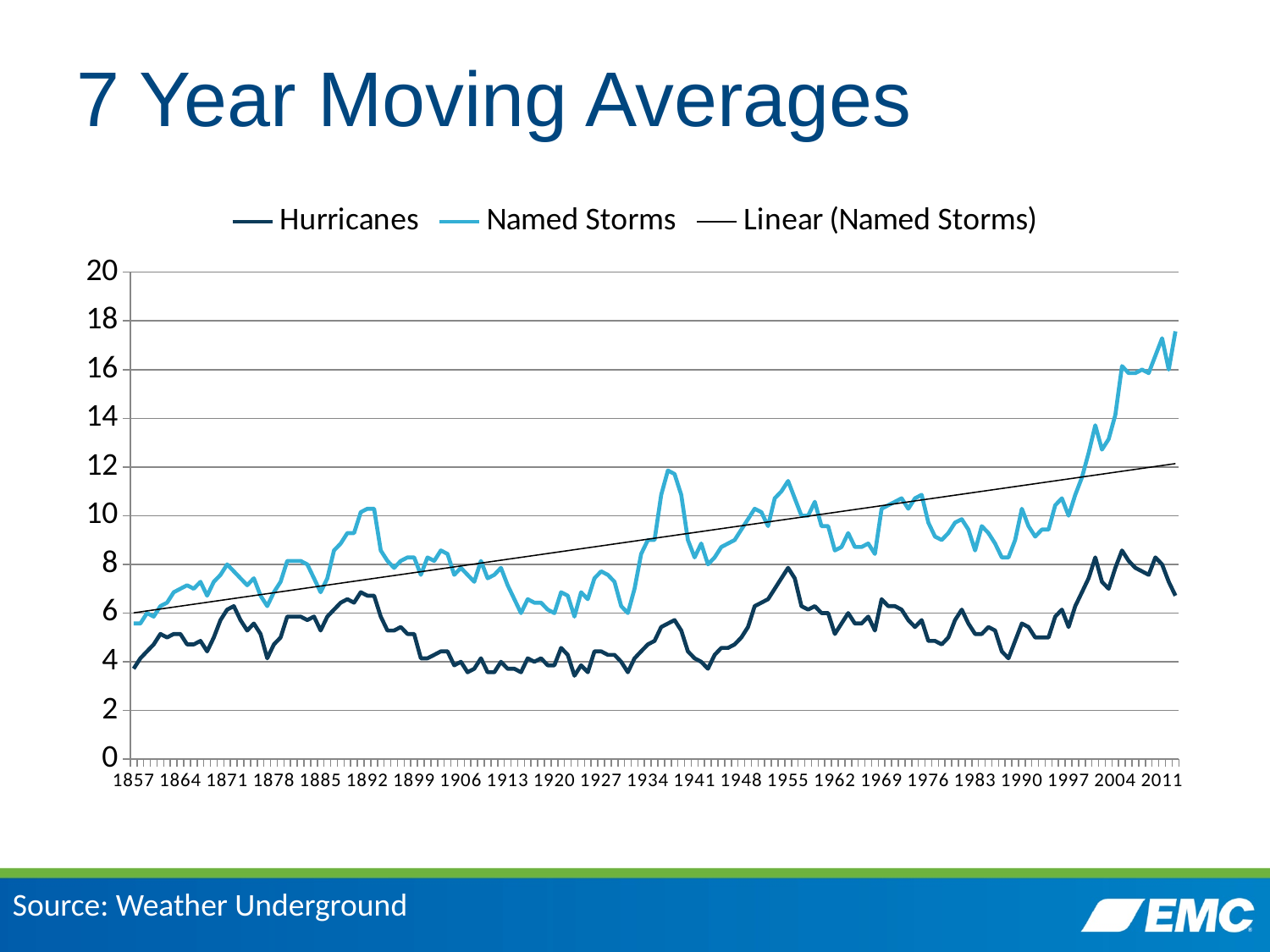
Around 1941, which is larger, the Hurricanes value or the Named Storms value? Named Storms Does the Linear (Named Storms) trend line rise or fall from 1857 to 2011? rise Is the Named Storms value around 2011 greater or less than 14? greater Is the Hurricanes value at 1857 greater or less than 6? less What is the title of the chart? 7 Year Moving Averages Is the Named Storms value around 1892 greater or less than 8? greater Which series is higher across the whole chart, Hurricanes or Named Storms? Named Storms Which series does the linear trend line in the legend belong to? Named Storms How many series does the legend list? 3 What kind of chart is shown on the slide? line chart